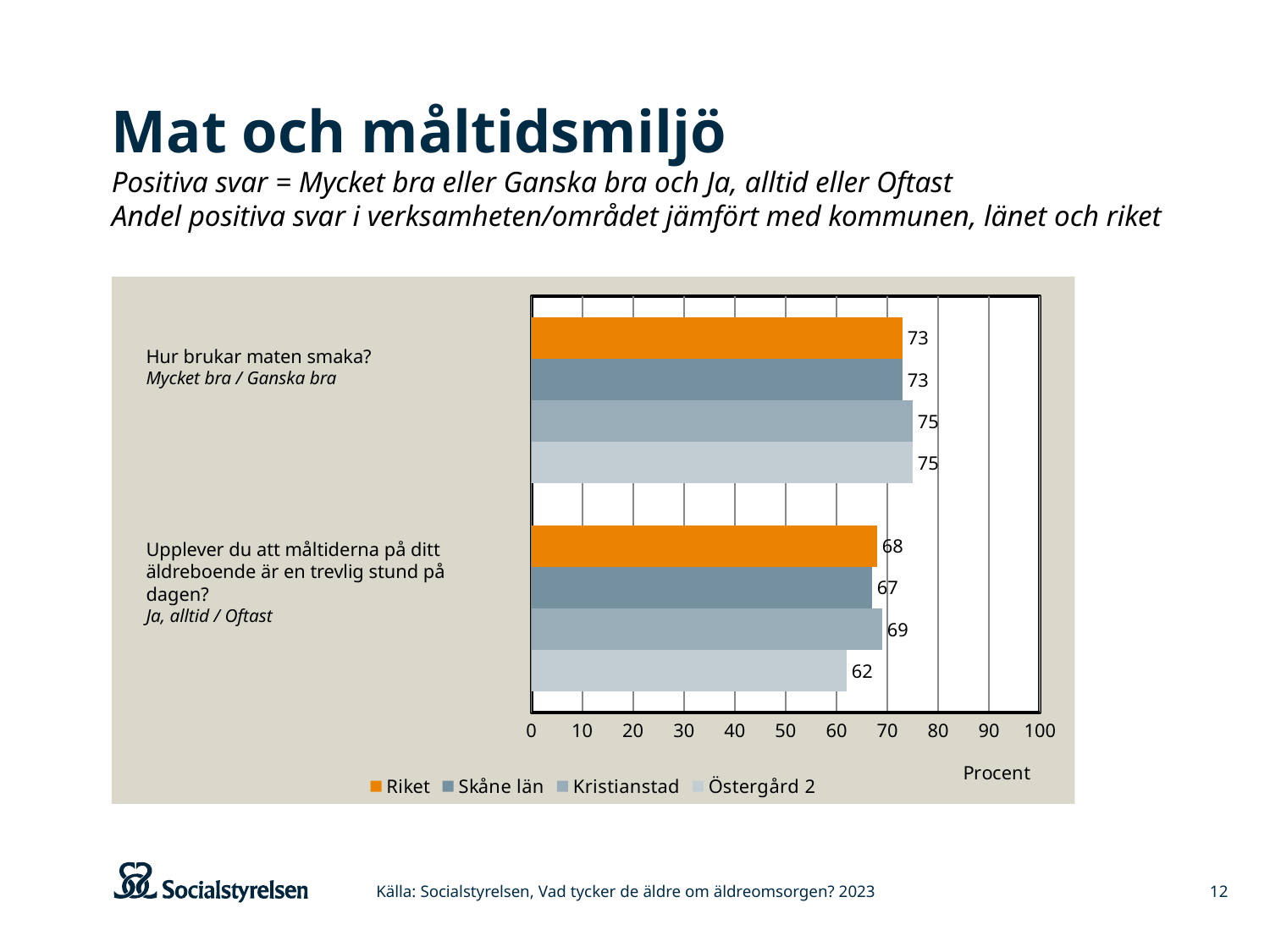
What kind of chart is shown on the slide? Bar chart What is the value for Skåne län on the question "Upplever du att måltiderna på ditt äldreboende är en trevlig stund på dagen?"? 67 Which series has the lowest value on the question "Upplever du att måltiderna på ditt äldreboende är en trevlig stund på dagen?"? Östergård 2 What is the value for Kristianstad on the question "Hur brukar maten smaka?"? 75 How many series does the legend list? 4 How many question categories are shown on the chart? 2 What is the difference between Kristianstad and Östergård 2 on the question "Upplever du att måltiderna på ditt äldreboende är en trevlig stund på dagen?"? 7 Is the value for Östergård 2 on the question "Upplever du att måltiderna på ditt äldreboende är en trevlig stund på dagen?" greater or less than 70? less Which is larger for Östergård 2: the value for "Hur brukar maten smaka?" or the value for "Upplever du att måltiderna på ditt äldreboende är en trevlig stund på dagen?"? Hur brukar maten smaka? What is the value for Riket on the question "Hur brukar maten smaka?"? 73 What is the value for Östergård 2 on the question "Upplever du att måltiderna på ditt äldreboende är en trevlig stund på dagen?"? 62 What is the label of the horizontal axis? Procent